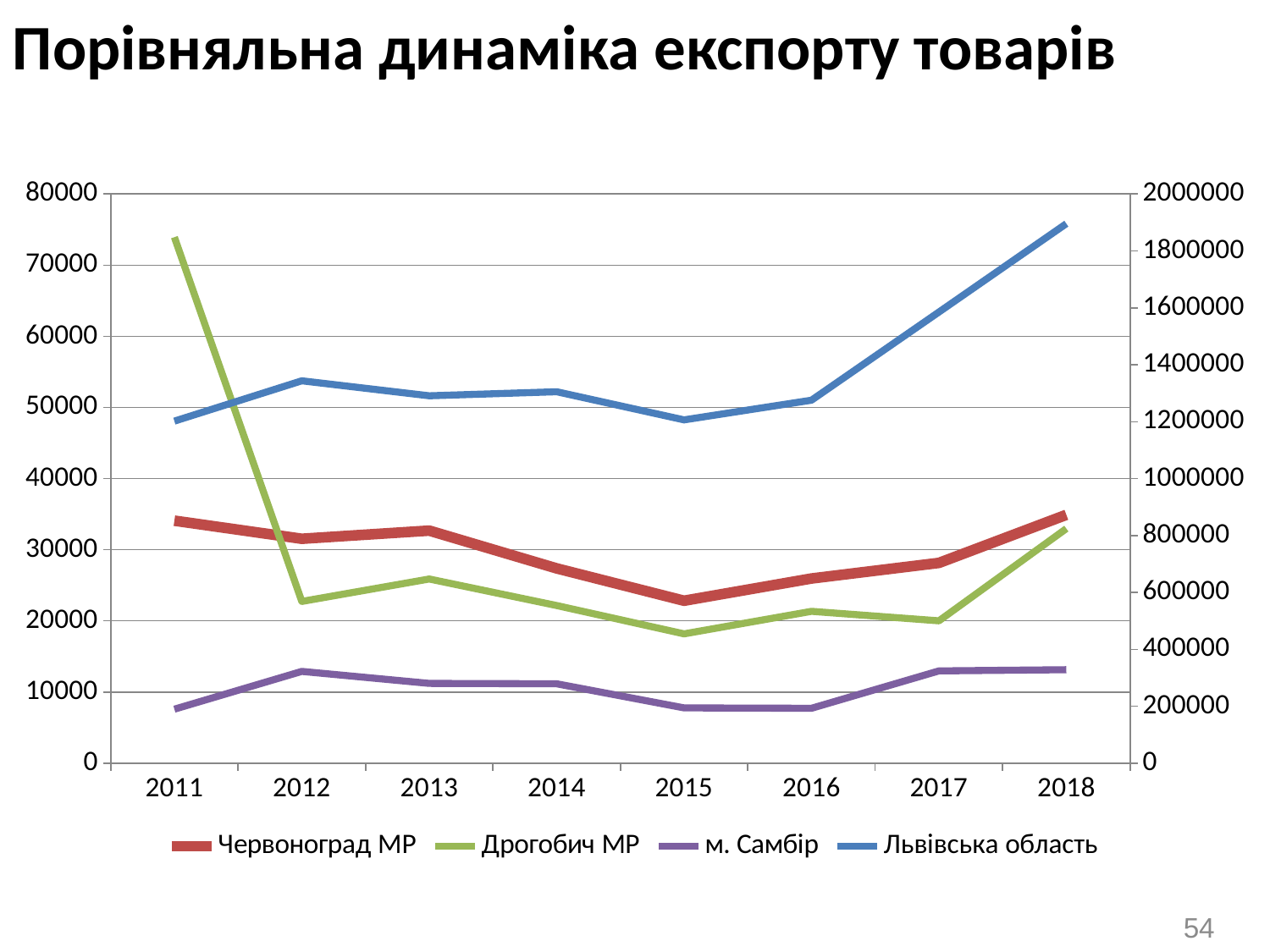
Is the value for Червоноград МР in 2015 greater or less than 30000 on the left axis? less How many series does the legend list? 4 How many years are shown on the x axis? 8 Does the line for Львівська область rise or fall from 2016 to 2018? rises Is the value for м. Самбір in 2012 greater or less than 10000 on the left axis? greater Is the value for Дрогобич МР in 2011 greater or less than 70000 on the left axis? greater In 2013, which is larger: Червоноград МР or Дрогобич МР? Червоноград МР What kind of chart is shown on the slide? line chart In which year does Дрогобич МР reach its highest value? 2011 In which year does Червоноград МР reach its lowest value? 2015 What is the title of the chart? Порівняльна динаміка експорту товарів In which year does Дрогобич МР reach its lowest value? 2015